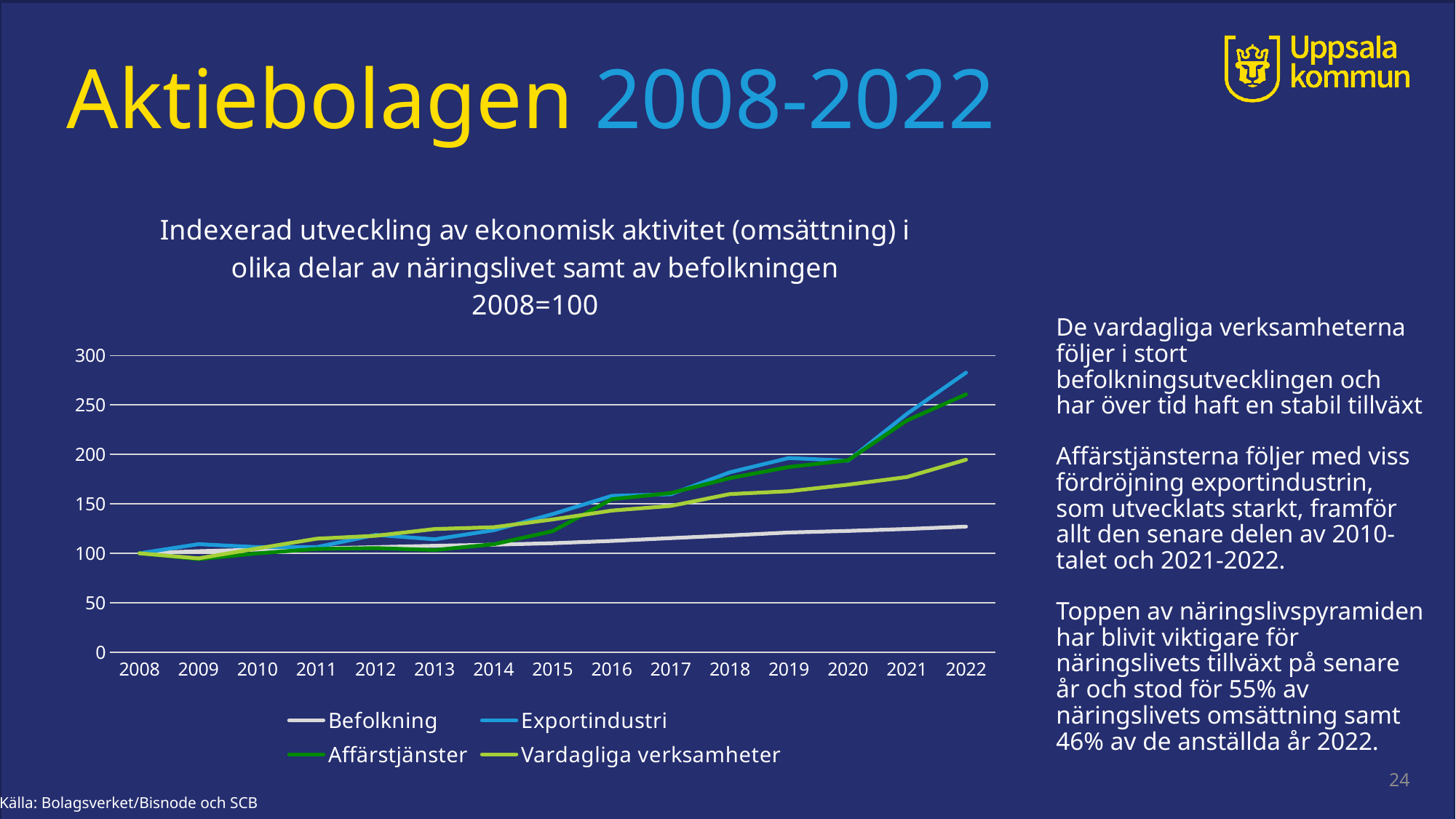
Does the Exportindustri line generally rise or fall from 2008 to 2022? rise Which series has the highest value in 2022? Exportindustri What is the first line of the chart title? Indexerad utveckling av ekonomisk aktivitet (omsättning) i Is the value for Exportindustri in 2022 greater or less than 250? greater Which is larger in 2022, Exportindustri or Befolkning? Exportindustri How many series does the legend list? 4 How many years are shown on the x axis? 15 What kind of chart is shown on the slide? line chart What is the index value of all series in 2008, according to the chart title? 100 Is the value for Befolkning in 2022 greater or less than 150? less Is the value for Affärstjänster in 2022 greater or less than 200? greater Which series has the lowest value in 2022? Befolkning